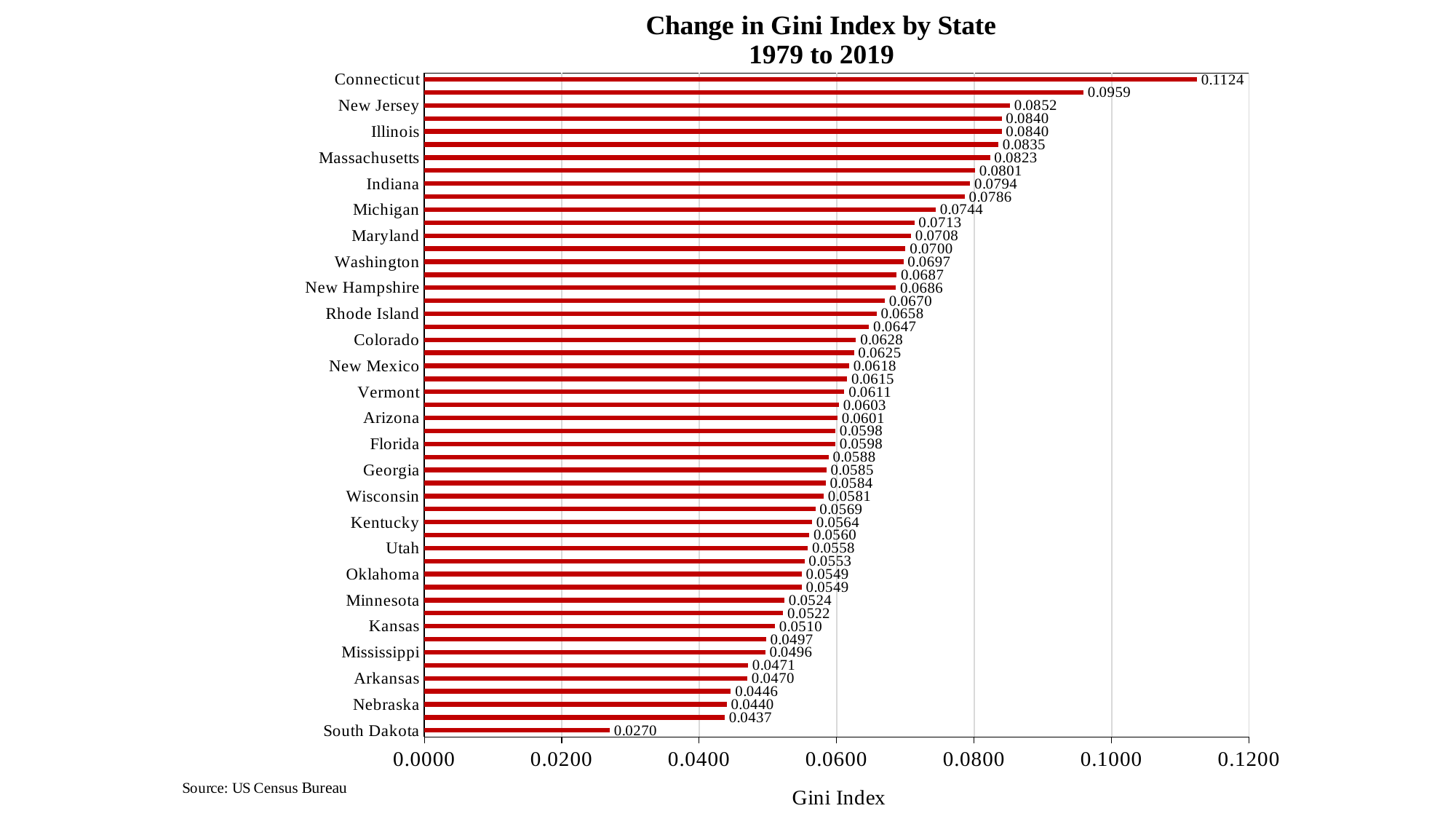
What is the change in Gini index for South Dakota? 0.0270 Which state has the smallest change in Gini index? South Dakota What is the change in Gini index for Michigan? 0.0744 What is the change in Gini index for Kansas? 0.0510 Which has a larger change in Gini index, New Jersey or Massachusetts? New Jersey What is the change in Gini index for Connecticut? 0.1124 Which state has the largest change in Gini index? Connecticut What is the difference between the change in Gini index for Connecticut and for South Dakota? 0.0854 What is the title of the chart? Change in Gini Index by State 1979 to 2019 Is the change in Gini index for Indiana greater or less than 0.0600? greater What type of chart is shown on the slide? Bar chart What is the source cited for the chart data? US Census Bureau